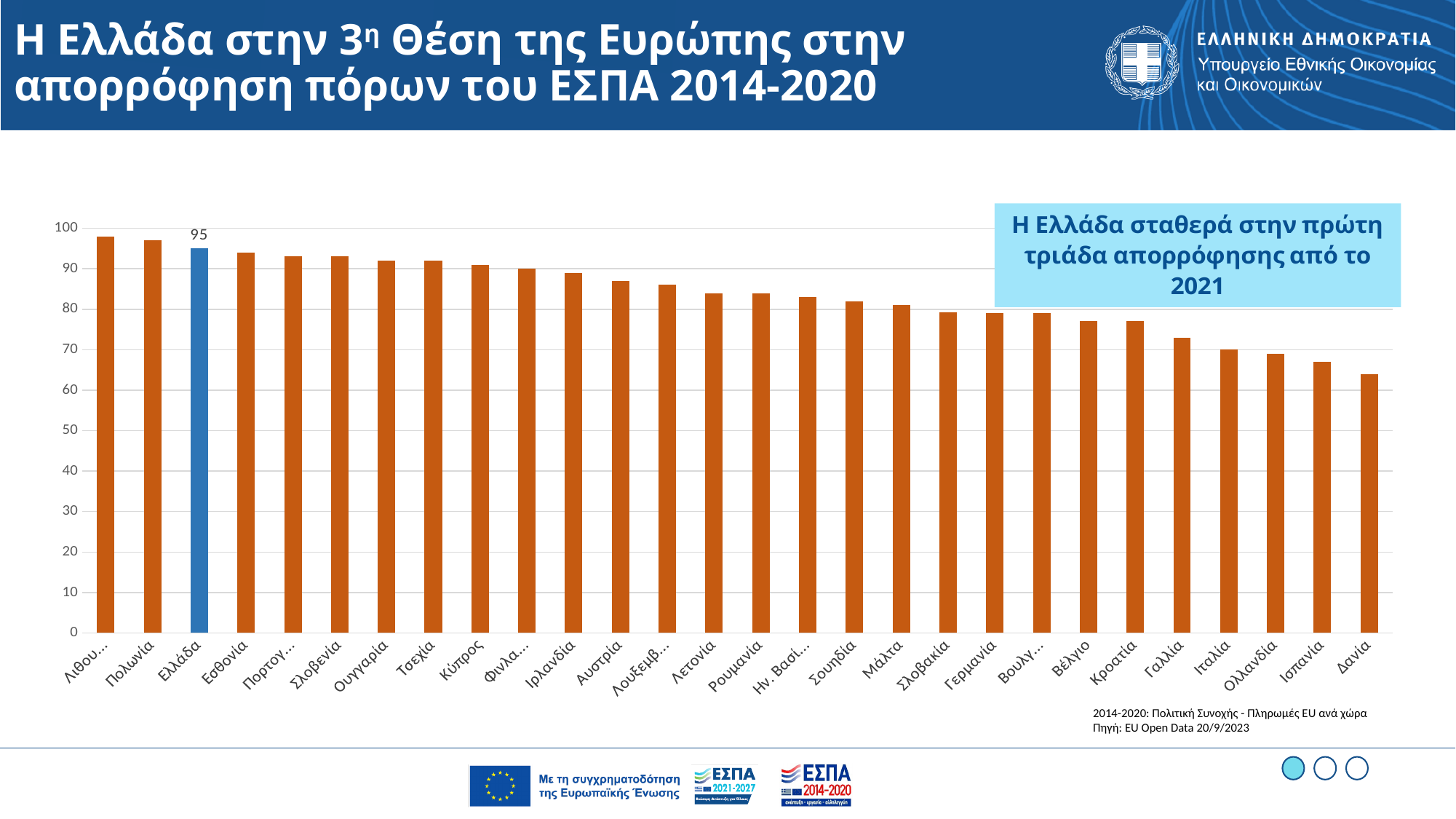
What value is printed above the bar for Ελλάδα? 95 Is the value for Κροατία greater or less than 80? less Do the bar values rise or fall from left to right along the x axis? fall Is the value for Πολωνία greater or less than 90? greater How many countries (bars) are shown in the chart? 28 Which has the larger value, Ελλάδα or Γερμανία? Ελλάδα Which country's bar is coloured blue instead of orange? Ελλάδα Which country has the lowest bar in the chart? Δανία Which has the larger value, Πολωνία or Δανία? Πολωνία Is the value for Αυστρία greater or less than 80? greater What kind of chart is shown on the slide? bar chart